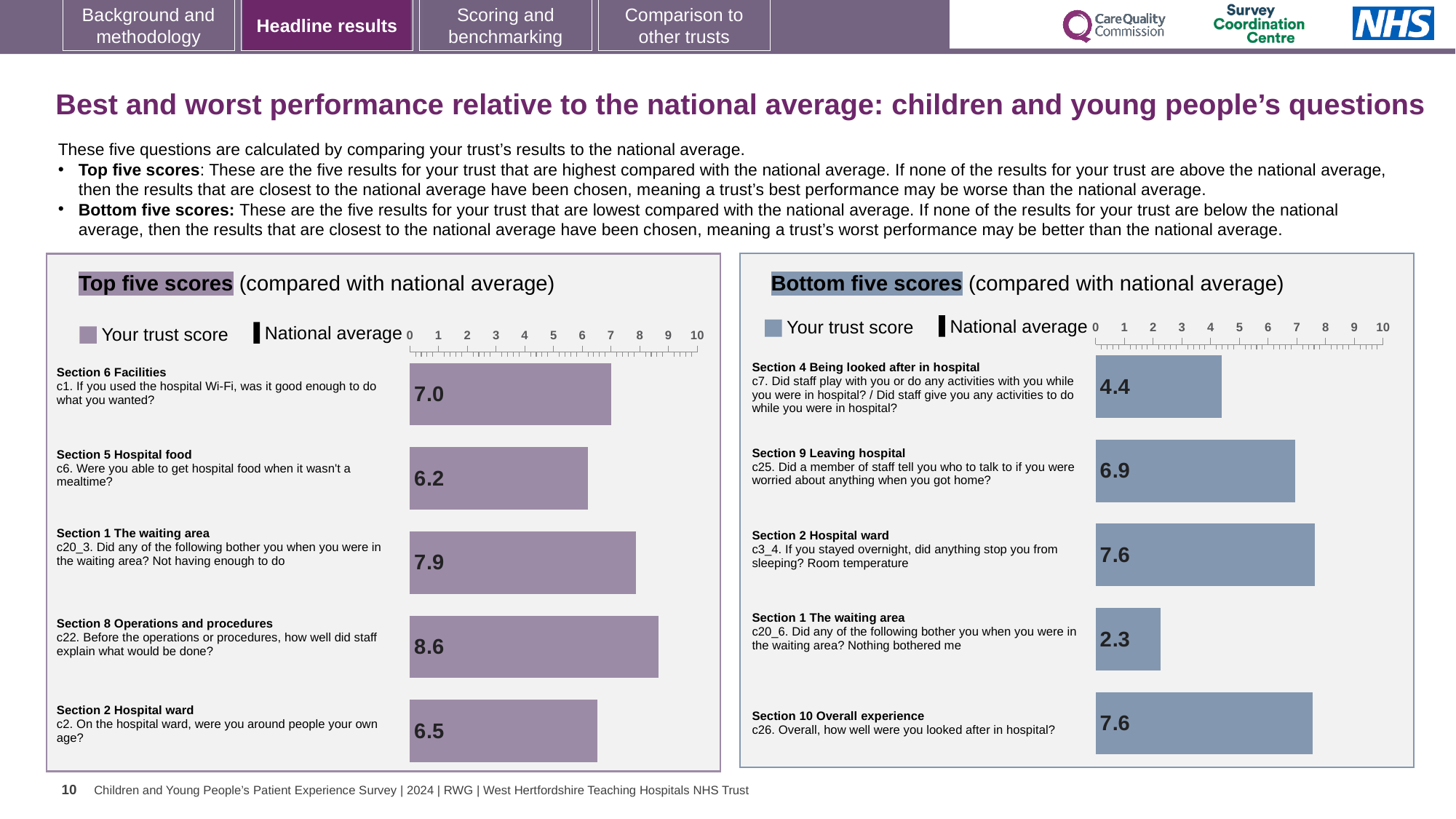
In the Bottom five scores chart, what is the trust score for c7 (Section 4 Being looked after in hospital)? 4.4 In the Top five scores chart, what is the difference between the trust scores for c22 and c2? 2.1 In the Top five scores chart, which question has the highest trust score? c22 (Section 8 Operations and procedures) In the Bottom five scores chart, which question has the lowest trust score? c20_6 (Section 1 The waiting area) In the Bottom five scores chart, which is larger: the trust score for c25 or for c7? c25 In the Top five scores chart, what is the trust score for c22 (Section 8 Operations and procedures)? 8.6 How many questions are shown in the Top five scores chart? 5 In the Bottom five scores chart, what is the difference between the trust scores for c25 and c20_6? 4.6 In the Top five scores chart, what is the trust score for c6 (Section 5 Hospital food)? 6.2 In the Top five scores chart, which question has the lowest trust score? c6 (Section 5 Hospital food) What type of chart is the Bottom five scores chart? Bar chart In the Bottom five scores chart, what is the trust score for c20_6 (Section 1 The waiting area)? 2.3